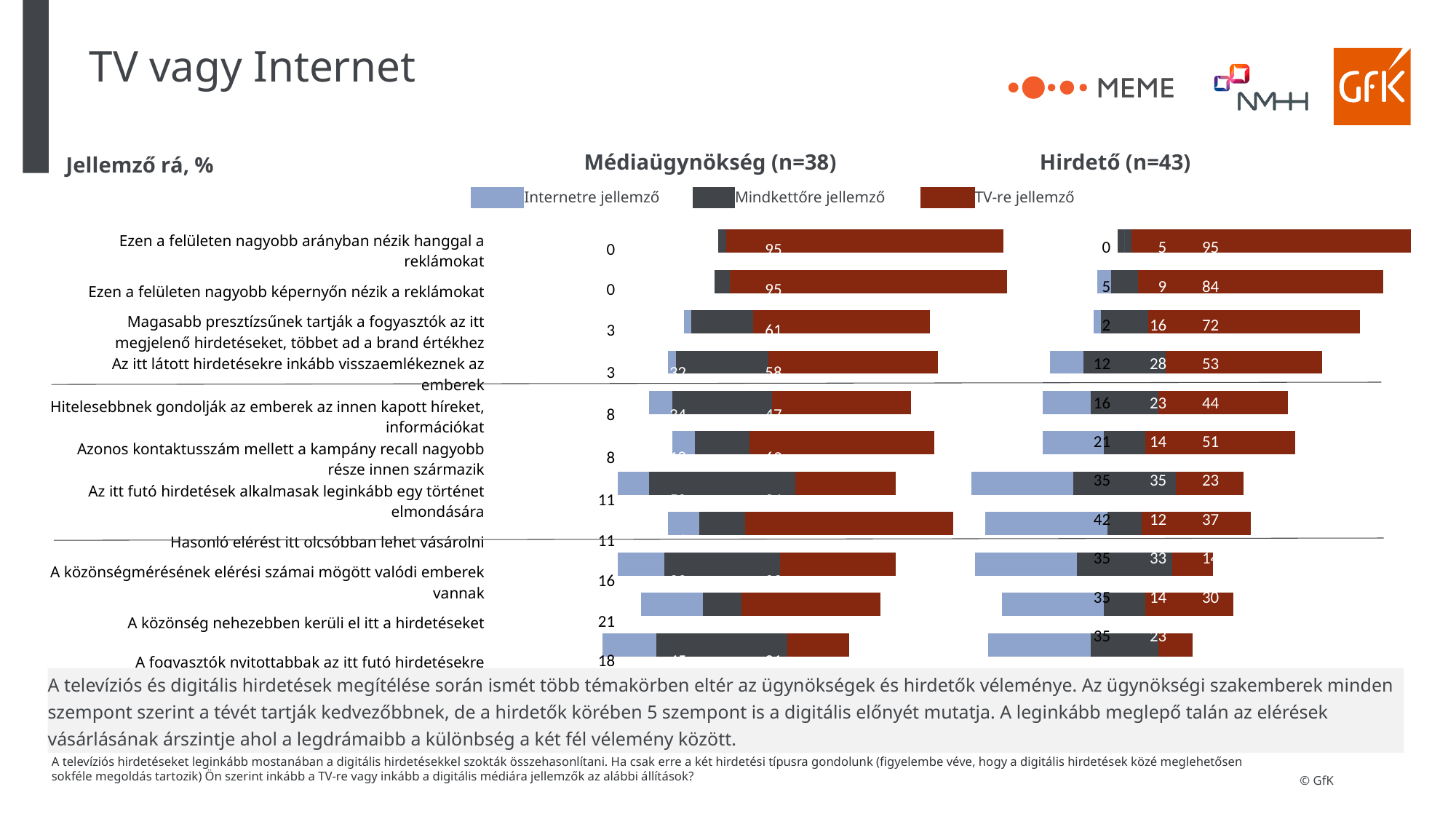
In the Médiaügynökség (n=38) chart, which series is shown in dark red? TV-re jellemző In the Hirdető (n=43) chart, which is larger for 'Hasonló elérést itt olcsóbban lehet vásárolni': the Internetre jellemző value or the TV-re jellemző value? Internetre jellemző In the Hirdető (n=43) chart, what is the Internetre jellemző value for 'Hasonló elérést itt olcsóbban lehet vásárolni'? 42 In the Hirdető (n=43) chart, what is the difference between the TV-re jellemző and Internetre jellemző values for 'Azonos kontaktusszám mellett a kampány recall nagyobb része innen származik'? 30 What is the sample size shown in the title of the Hirdető chart? n=43 In the Médiaügynökség (n=38) chart, what is the TV-re jellemző value for 'Magasabb presztízsűnek tartják a fogyasztók az itt megjelenő hirdetéseket, többet ad a brand értékhez'? 61 In the Médiaügynökség (n=38) chart, what is the Internetre jellemző value for 'A közönség nehezebben kerüli el itt a hirdetéseket'? 21 In the Hirdető (n=43) chart, what is the total of the stacked bar for 'Ezen a felületen nagyobb képernyőn nézik a reklámokat'? 98 How many series does the legend list? 3 In the Hirdető (n=43) chart, what is the TV-re jellemző value for 'Ezen a felületen nagyobb arányban nézik hanggal a reklámokat'? 95 In the Hirdető (n=43) chart, what is the Mindkettőre jellemző value for 'Az itt látott hirdetésekre inkább visszaemlékeznek az emberek'? 28 What kind of chart is used on this slide? stacked bar chart